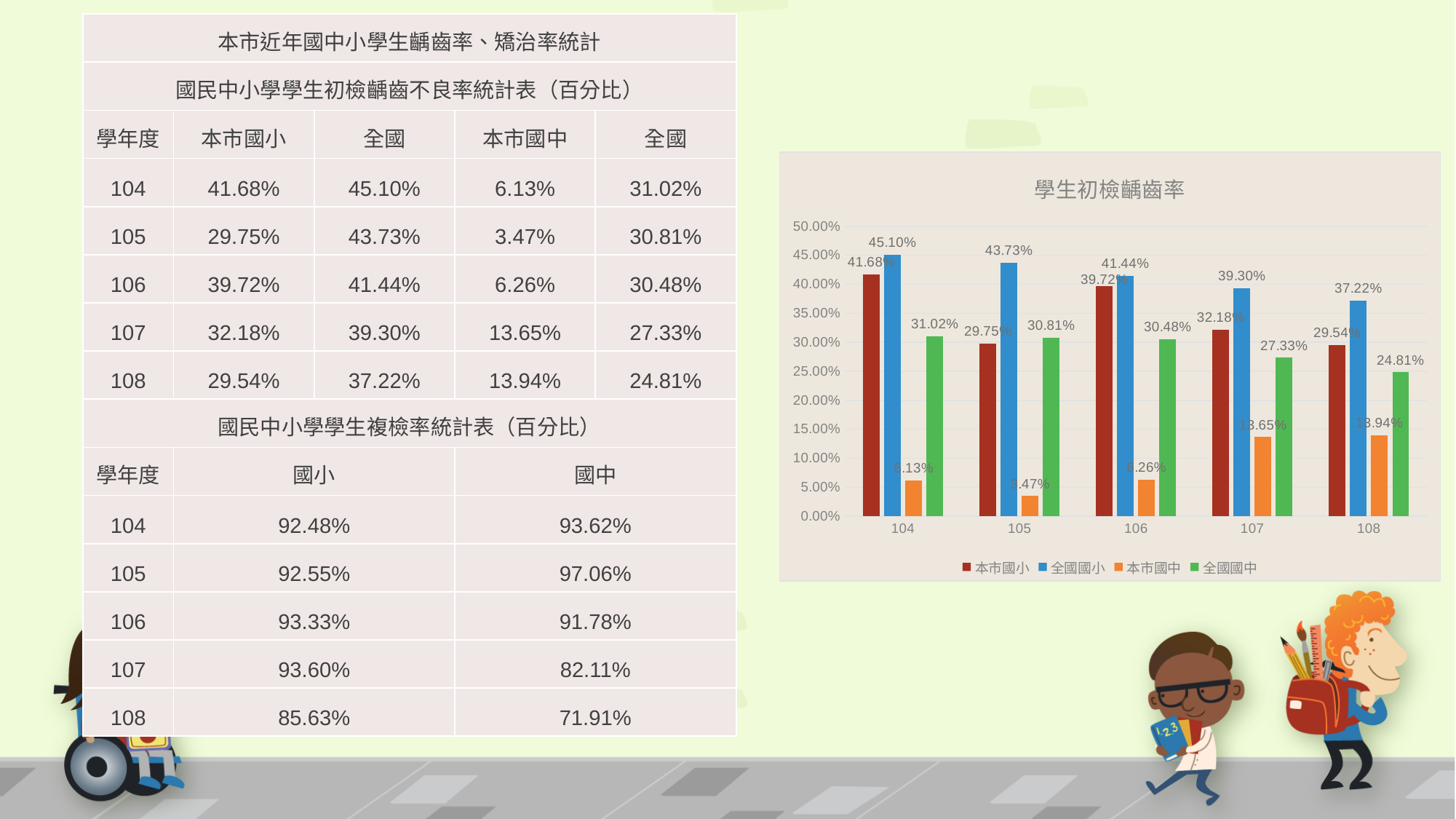
What is the value for 本市國中 in 105? 3.47% In which school year is the 本市國小 value highest? 104 What kind of chart is shown on the slide? bar chart Which is larger in 106: 本市國小 or 全國國中? 本市國小 How many series does the chart legend list? 4 What is the value for 全國國中 in 108? 24.81% In which school year is the 本市國中 value lowest? 105 What is the difference between 全國國小 and 本市國小 in 107? 7.12% Does the 全國國小 value rise or fall from 104 to 108? fall How many school-year categories are shown on the x axis of the chart? 5 What is the value for 全國國小 in 104? 45.10% What is the title of the chart? 學生初檢齲齒率